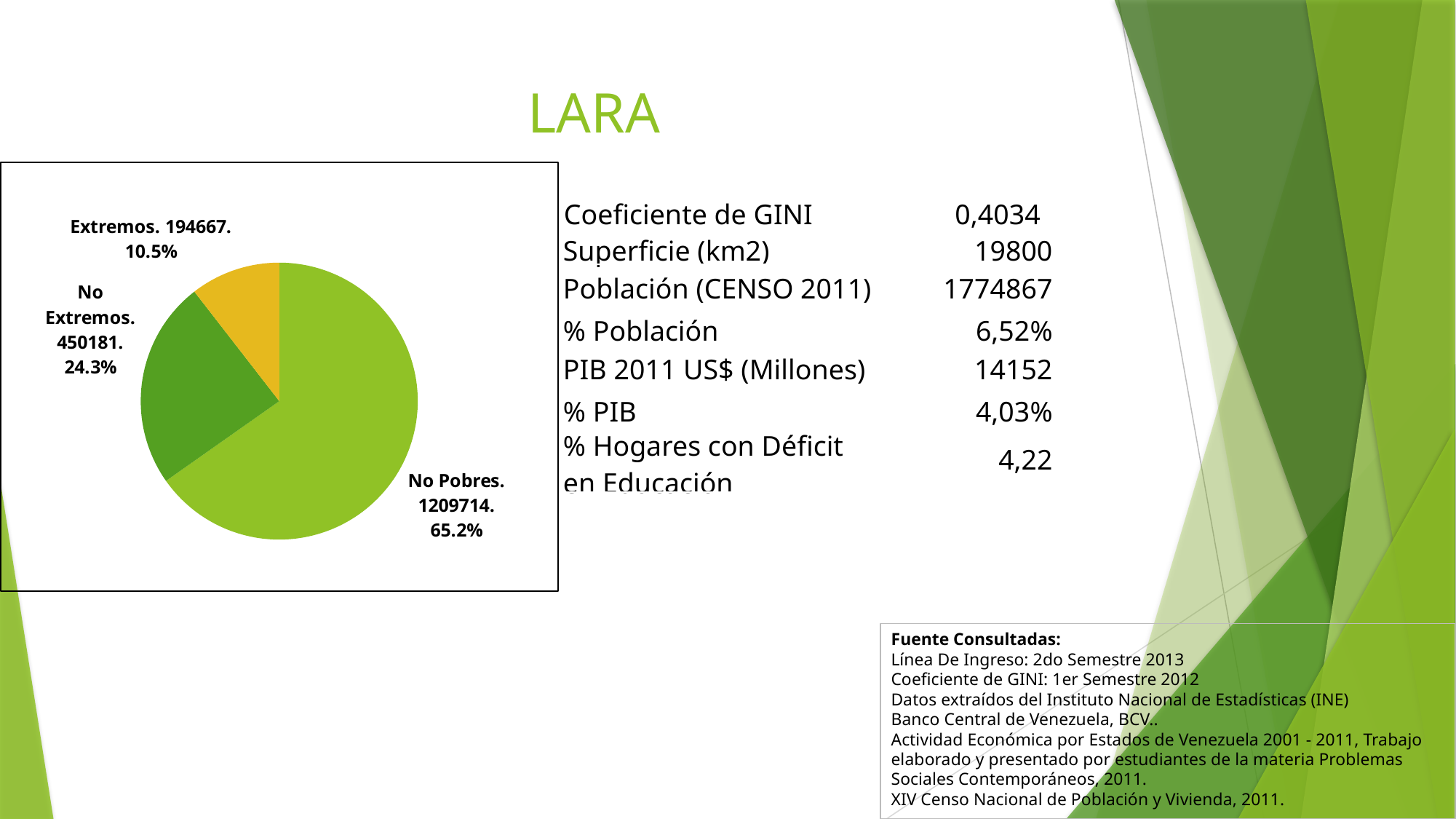
What share of the pie does the No Extremos slice represent? 24.3% What share of the pie does the No Pobres slice represent? 65.2% Which slice of the pie chart is the smallest? Extremos What kind of chart is shown on the slide? pie chart What is the value shown for the No Pobres slice? 1209714 Which slice of the pie chart is the largest? No Pobres What is the value shown for the No Extremos slice? 450181 What share of the pie does the Extremos slice represent? 10.5% What is the difference between the No Pobres value and the No Extremos value? 759533 What is the value shown for the Extremos slice? 194667 Which slice is larger, No Extremos or Extremos? No Extremos How many slices does the pie chart have? 3